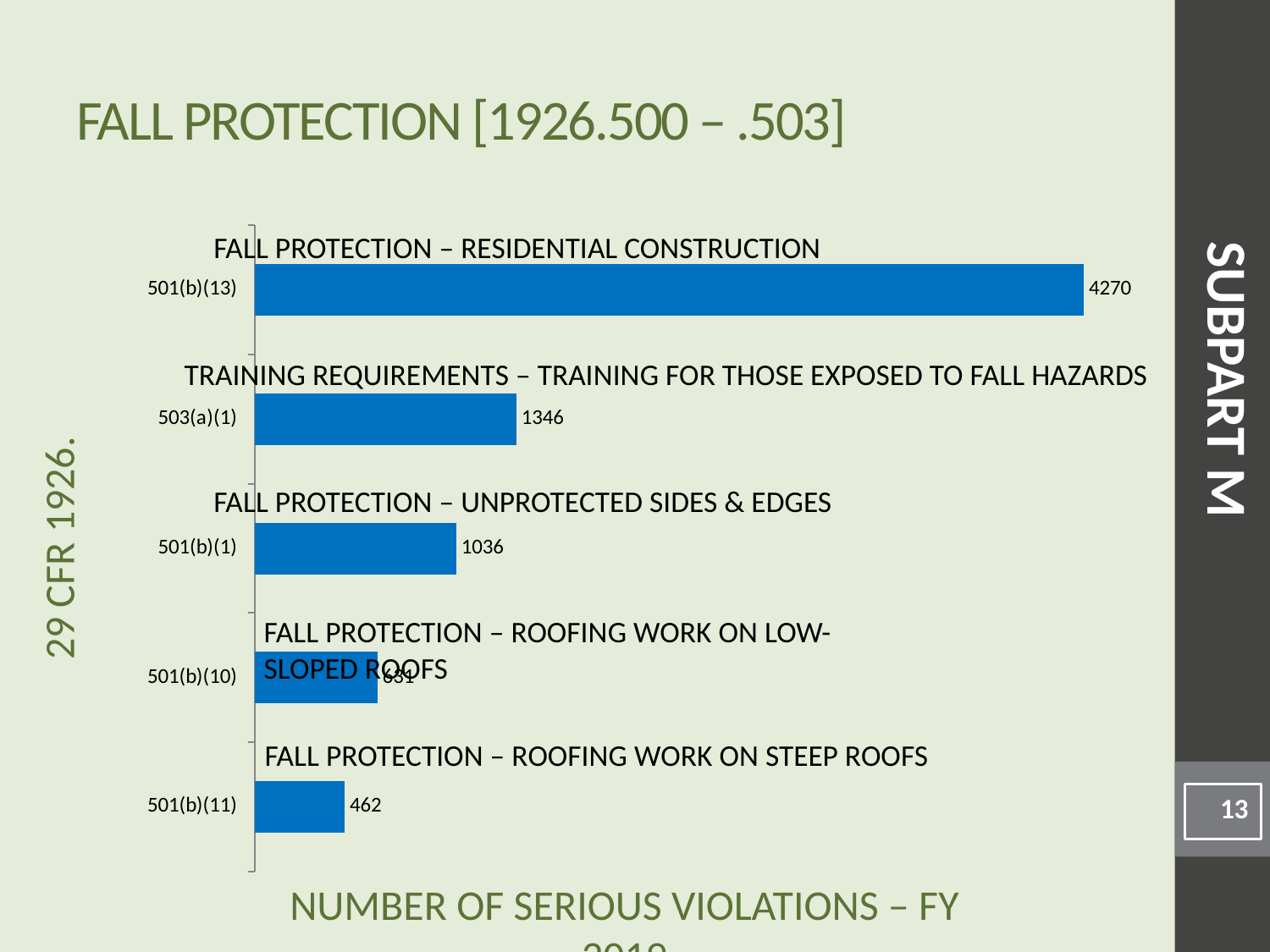
What is the number of serious violations for 503(a)(1)? 1346 What type of chart is shown on the slide? Bar chart Which standard has the lowest number of serious violations? 501(b)(11) What colour are the bars in the chart? Blue Which standard has the highest number of serious violations? 501(b)(13) What is the number of serious violations for 501(b)(1)? 1036 What is the number of serious violations for 501(b)(13)? 4270 How many standards (categories) are shown in the chart? 5 Which has more serious violations, 501(b)(1) or 501(b)(11)? 501(b)(1) What is the difference between the number of violations for 503(a)(1) and 501(b)(1)? 310 What is the number of serious violations for 501(b)(11)? 462 What is the difference between the number of violations for 501(b)(13) and 503(a)(1)? 2924